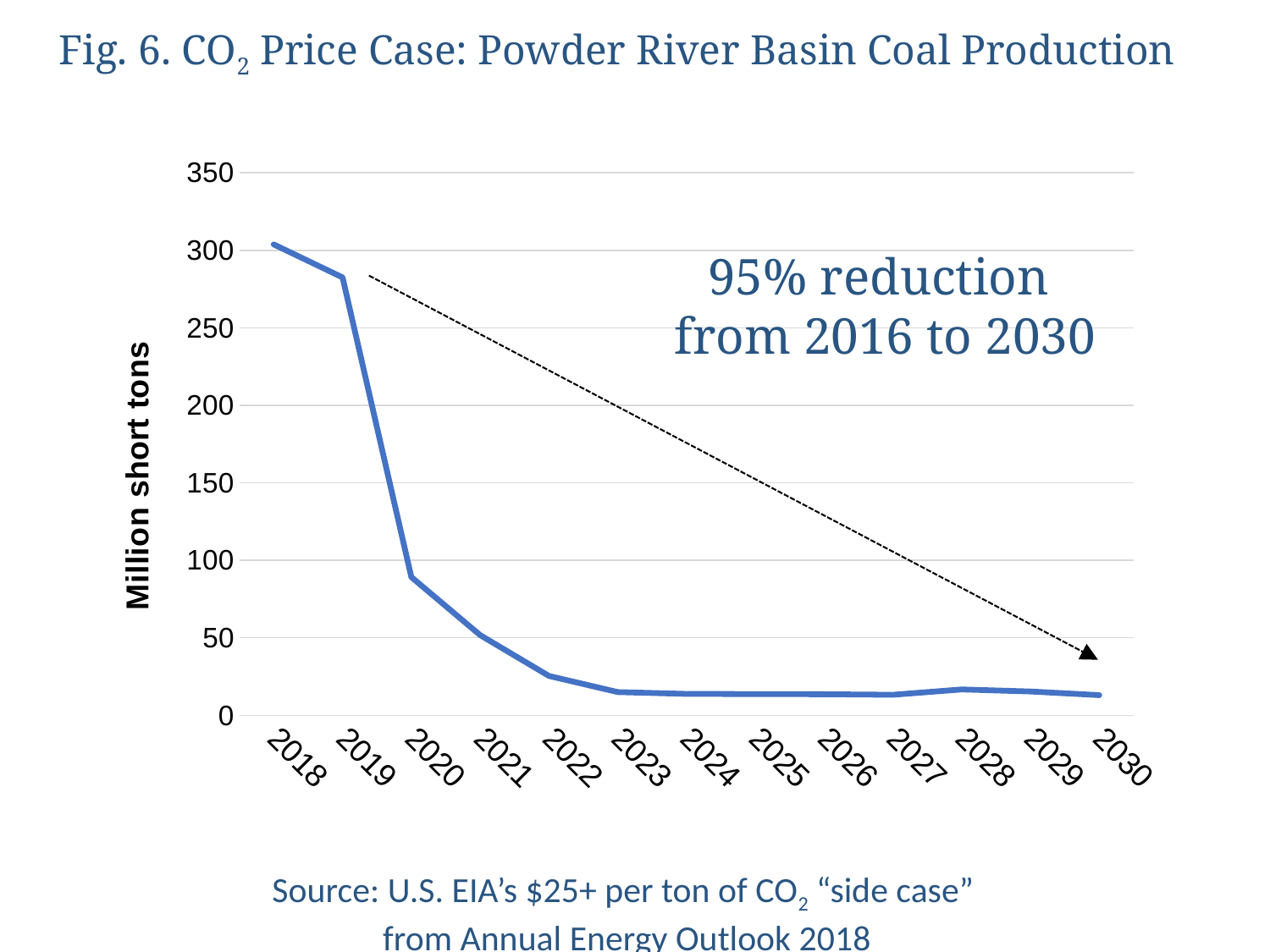
Which year has the larger value, 2019 or 2020? 2019 Is the value for 2022 greater or less than 50? less Is the value for 2025 greater or less than 50? less Is the value for 2019 greater or less than 250? greater How many years are plotted along the x axis? 13 Which year has the highest coal production value? 2018 Do the values generally rise or fall from 2018 to 2030? fall What reduction does the annotation on the chart state from 2016 to 2030? 95% reduction What kind of chart is shown on the slide? line chart What is the label on the y axis? Million short tons